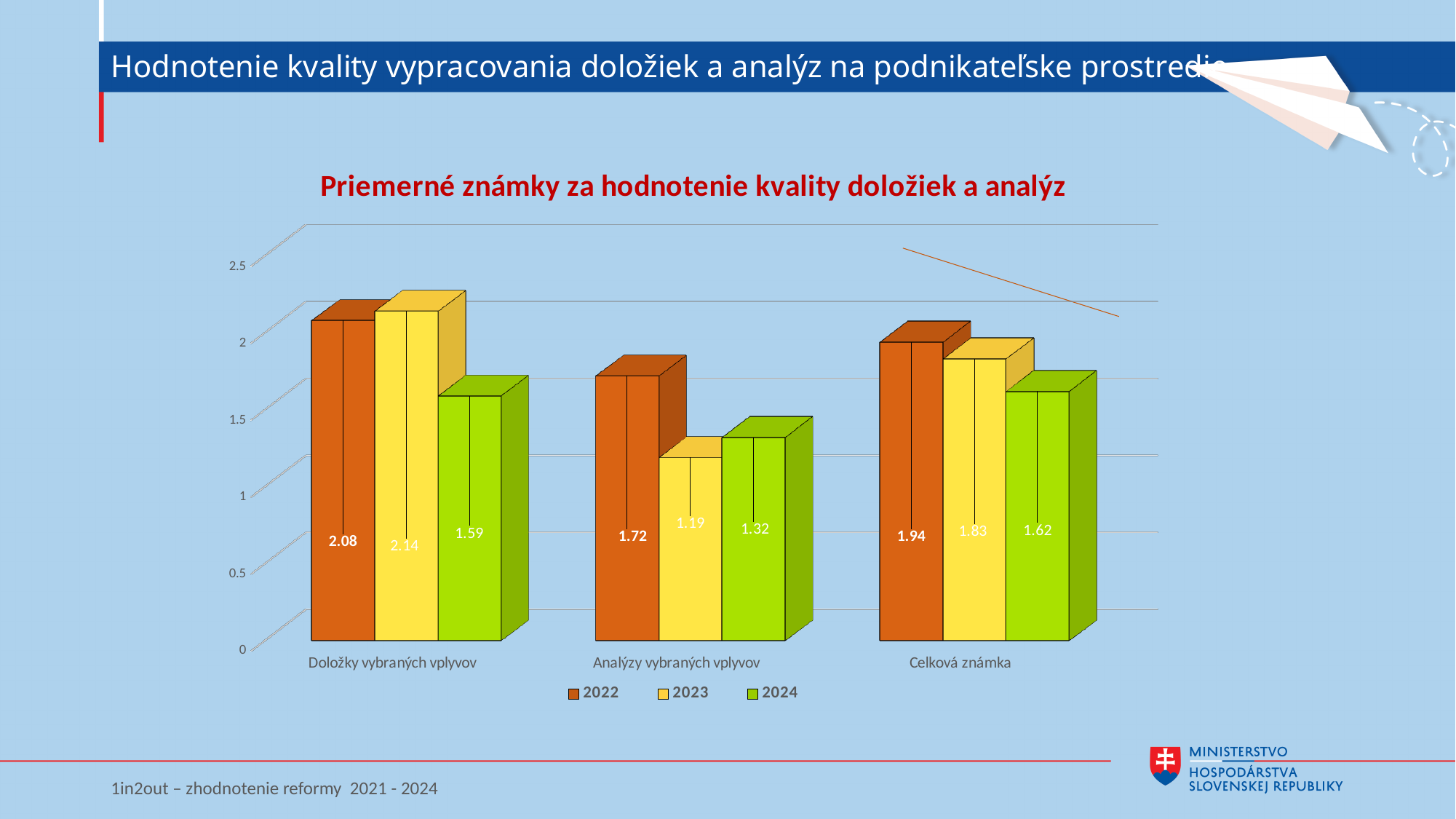
What is the value for 2023 in the Analýzy vybraných vplyvov category? 1.19 Which year has the highest value in the Doložky vybraných vplyvov category? 2023 What is the title of the chart? Priemerné známky za hodnotenie kvality doložiek a analýz Which is larger: the 2022 value for Analýzy vybraných vplyvov or the 2022 value for Celková známka? Celková známka How many series does the legend list? 3 What kind of chart is shown on the slide? Bar chart How many categories are shown on the x axis? 3 Which colour represents the 2024 series in the legend? Green What is the value for 2024 in the Celková známka category? 1.62 What is the value for 2022 in the Doložky vybraných vplyvov category? 2.08 Which year has the lowest value in the Analýzy vybraných vplyvov category? 2023 What is the difference between the 2022 and 2024 values in the Celková známka category? 0.32